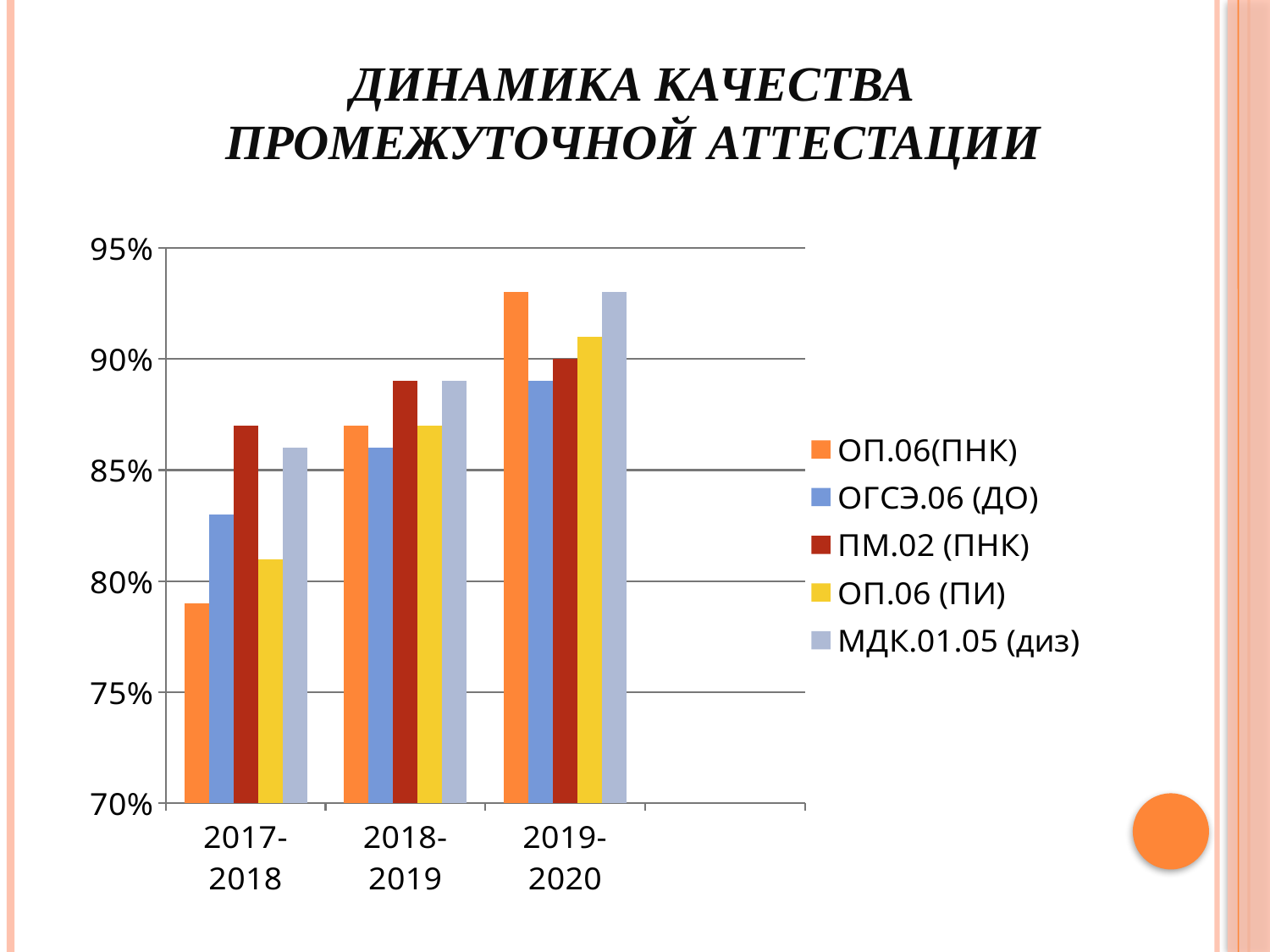
In 2019-2020, which is larger: ОП.06 (ПИ) or ОГСЭ.06 (ДО)? ОП.06 (ПИ) What is the title of the slide? ДИНАМИКА КАЧЕСТВА ПРОМЕЖУТОЧНОЙ АТТЕСТАЦИИ Is the value for ОГСЭ.06 (ДО) in 2017-2018 greater or less than 85%? less Which series has the lowest value in 2017-2018? ОП.06(ПНК) In 2017-2018, which is larger: ПМ.02 (ПНК) or ОГСЭ.06 (ДО)? ПМ.02 (ПНК) Do the values for ОП.06(ПНК) rise or fall from 2017-2018 to 2019-2020? rise How many series does the legend list? 5 What is the value for ПМ.02 (ПНК) in 2019-2020? 90% How many academic-year categories are shown on the x axis? 3 Is the value for ОП.06(ПНК) in 2017-2018 greater or less than 80%? less What kind of chart is shown on the slide? bar chart Is the value for ОП.06(ПНК) in 2019-2020 greater or less than 90%? greater